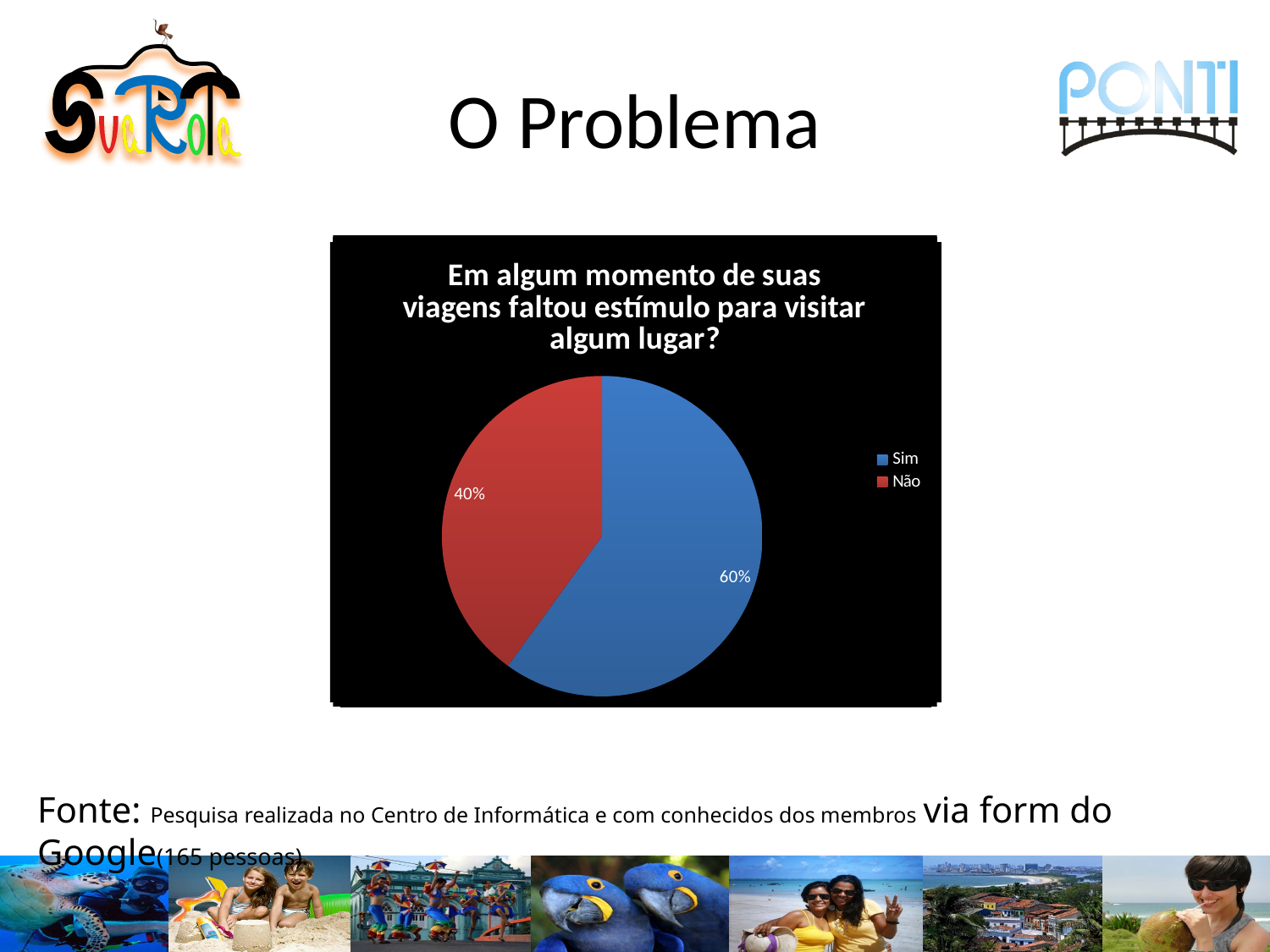
How many entries does the legend list? 2 Which slice of the pie is the largest? Sim What kind of chart is shown on the slide? pie chart What colour is the "Sim" slice in the pie chart? blue What percentage of the pie is labelled for "Sim"? 60% What share of the pie does the "Não" slice represent? 40% What is the title of the pie chart? Em algum momento de suas viagens faltou estímulo para visitar algum lugar? What is the difference in percentage points between the "Sim" and "Não" slices? 20% Which is larger, the "Sim" slice or the "Não" slice? Sim Which slice of the pie is the smallest? Não How many slices does the pie chart have? 2 What percentage of the pie is labelled for "Não"? 40%